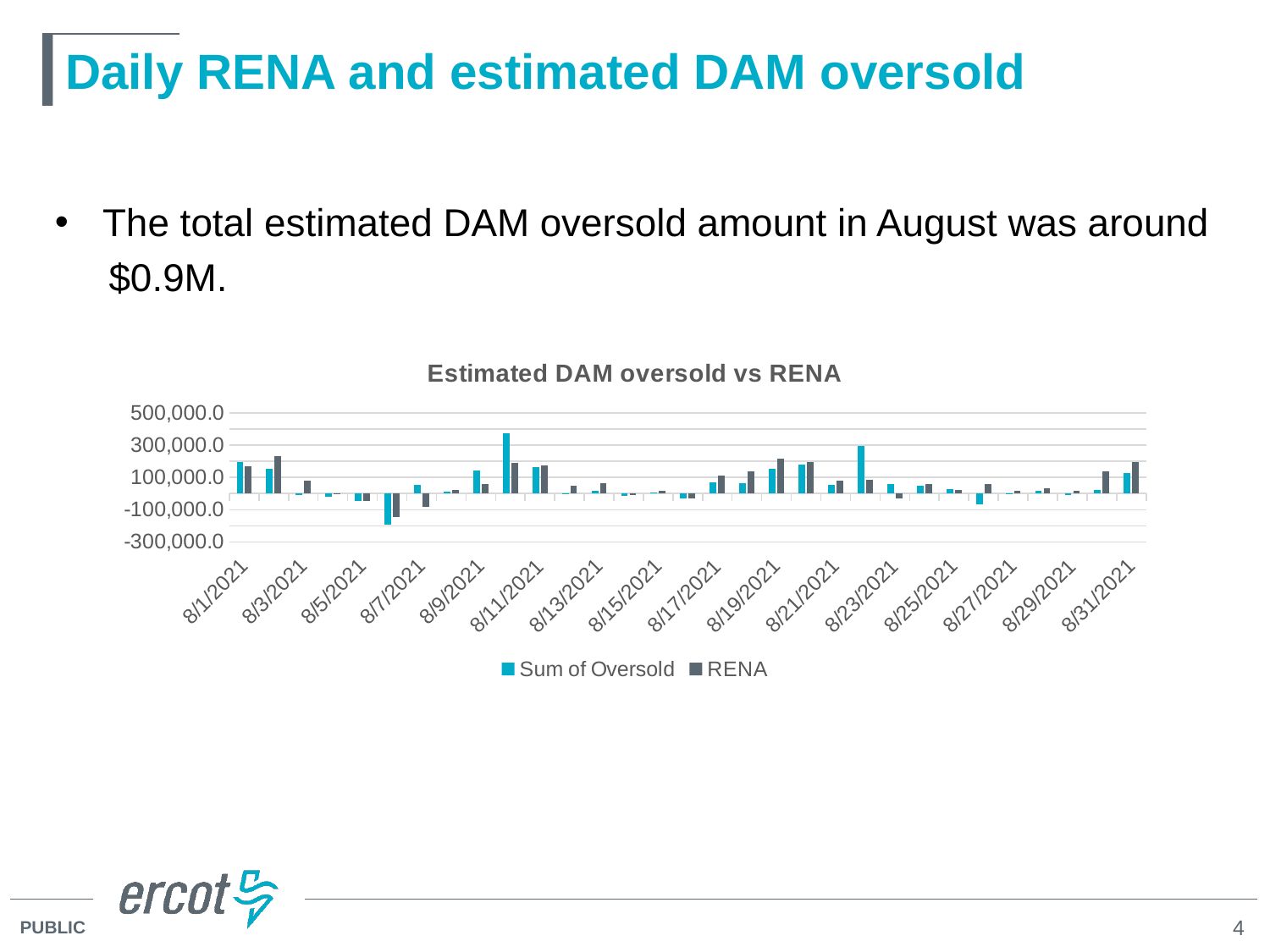
Is the Sum of Oversold value for 8/7/2021 greater or less than -100,000.0? greater What is the title of the chart? Estimated DAM oversold vs RENA On which date is the Sum of Oversold value lowest? 8/6/2021 Which date has the larger Sum of Oversold value, 8/11/2021 or 8/1/2021? 8/1/2021 Which series is drawn in teal in the chart? Sum of Oversold How many series does the chart legend list? 2 Is the Sum of Oversold value for 8/11/2021 greater or less than 300,000.0? less Is the Sum of Oversold value for 8/1/2021 greater or less than 100,000.0? greater What kind of chart is shown on the slide? Bar chart On which date is the Sum of Oversold value highest? 8/10/2021